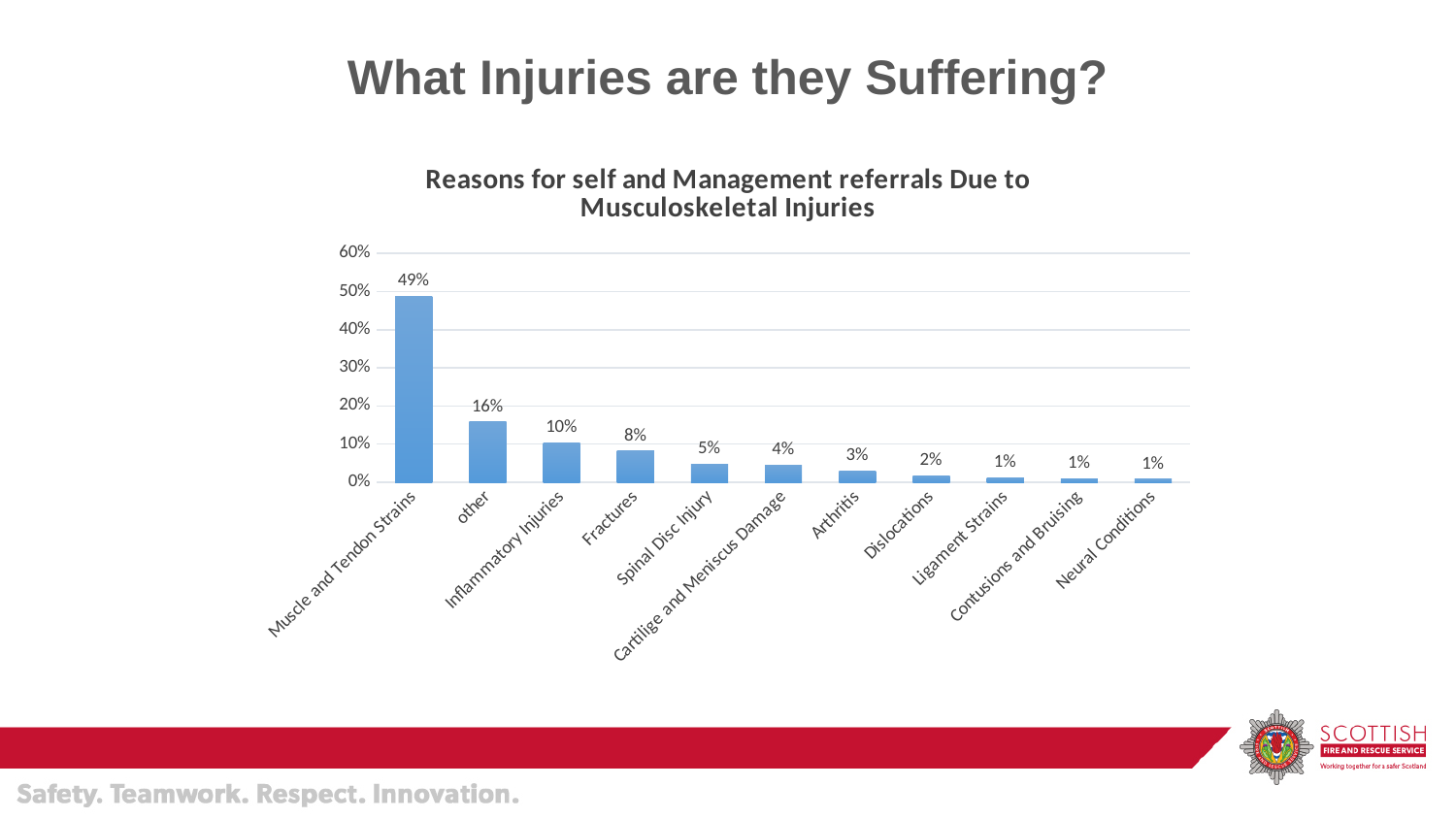
Which is larger, the value for other or the value for Inflammatory Injuries? other What is the value for Spinal Disc Injury? 5% What is the value for Arthritis? 3% What kind of chart is shown on the slide? Bar chart What is the difference between the values for Fractures and Dislocations? 6% What is the value for Inflammatory Injuries? 10% How many categories are shown on the x axis? 11 Which category has the highest value? Muscle and Tendon Strains What is the difference between the values for Muscle and Tendon Strains and other? 33% What is the value for Muscle and Tendon Strains? 49% What is the title of the chart? Reasons for self and Management referrals Due to Musculoskeletal Injuries Is the value for Fractures greater or less than 10%? less